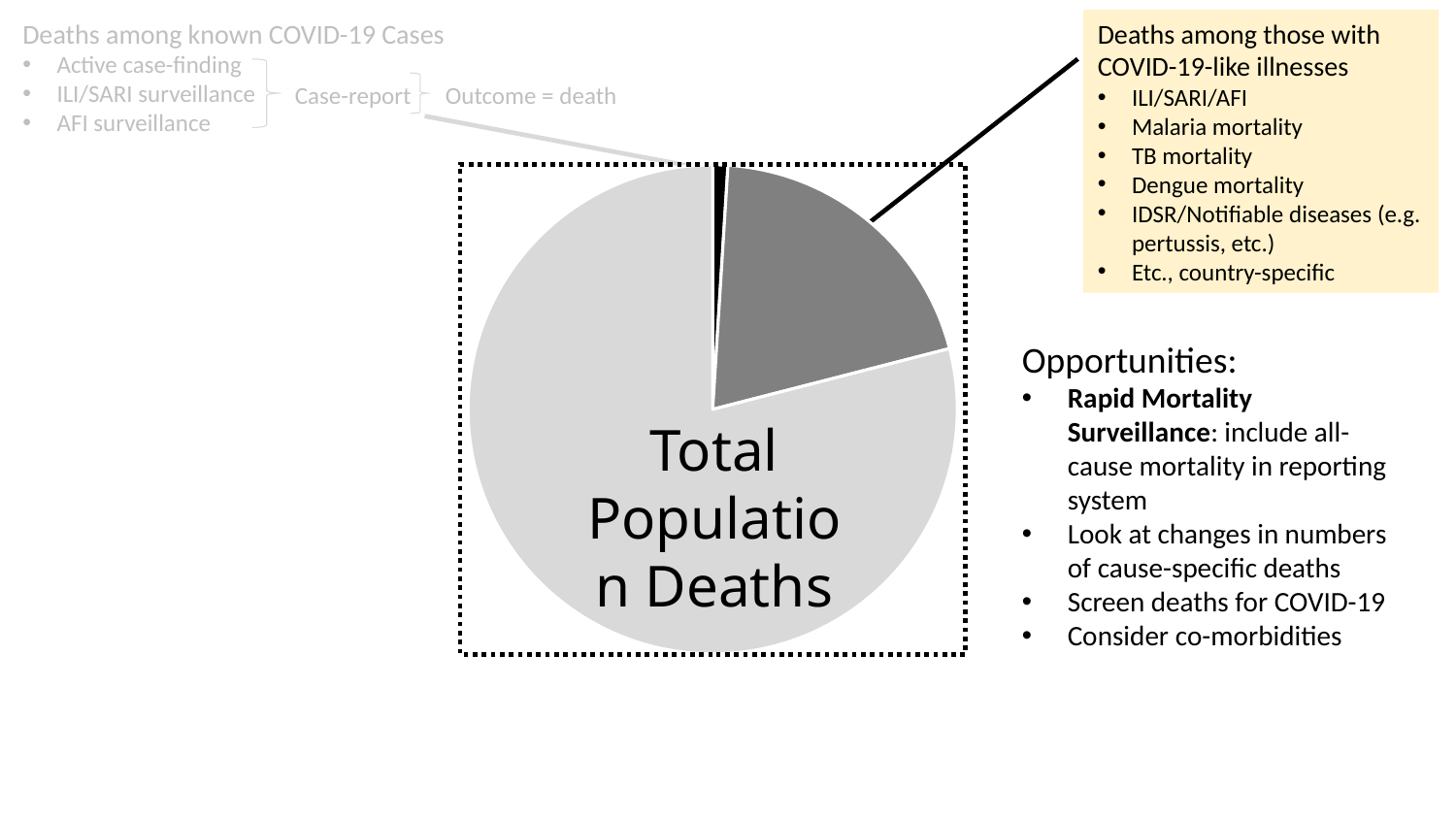
What text label is printed inside the largest slice of the pie chart? Total Population Deaths Which slice of the pie chart is the largest? Total Population Deaths Which is larger in the pie chart: the slice for deaths among those with COVID-19-like illnesses or the slice for deaths among known COVID-19 cases? Deaths among those with COVID-19-like illnesses Which slice of the pie chart is the smallest? Deaths among known COVID-19 Cases Which is larger in the pie chart: the Total Population Deaths slice or the slice for deaths among those with COVID-19-like illnesses? Total Population Deaths What kind of chart is shown on the slide? Pie chart How many slices does the pie chart have? 3 What colour is the smallest slice of the pie chart? Black